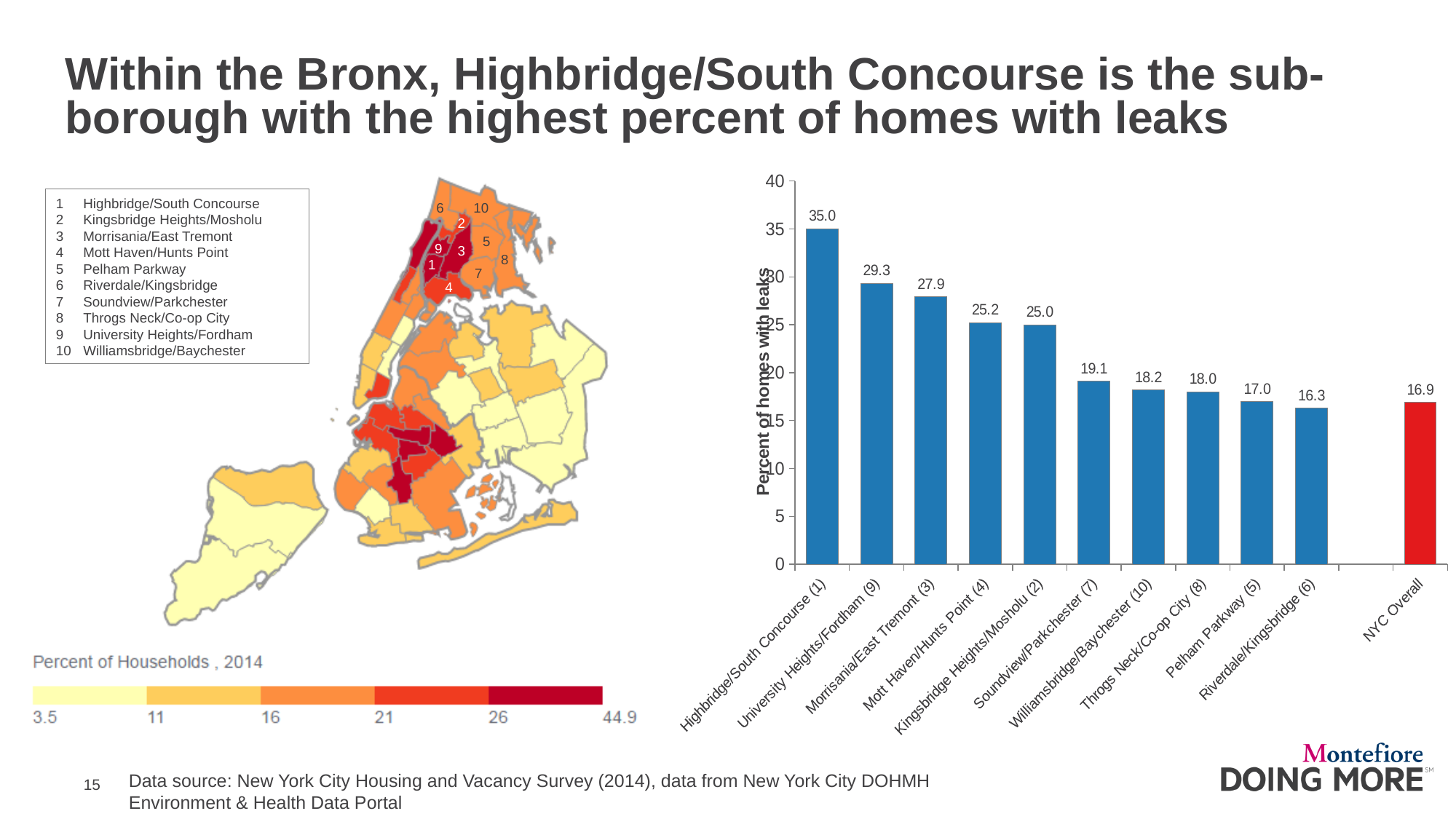
What is the difference in percent of homes with leaks between University Heights/Fordham (9) and Morrisania/East Tremont (3)? 1.4 Which has a higher percent of homes with leaks, Mott Haven/Hunts Point (4) or Pelham Parkway (5)? Mott Haven/Hunts Point (4) Is the value for Williamsbridge/Baychester (10) greater or less than 20? less What is the percent of homes with leaks for Soundview/Parkchester (7)? 19.1 How many bars are plotted in the bar chart? 11 Which sub-borough has the lowest percent of homes with leaks? Riverdale/Kingsbridge (6) What is the difference in percent of homes with leaks between Highbridge/South Concourse (1) and NYC Overall? 18.1 What kind of chart is shown on the right side of the slide? bar chart What is the percent of homes with leaks for NYC Overall? 16.9 What is the label of the y axis of the bar chart? Percent of homes with leaks What is the percent of homes with leaks for Highbridge/South Concourse (1)? 35.0 Which sub-borough has the highest percent of homes with leaks? Highbridge/South Concourse (1)